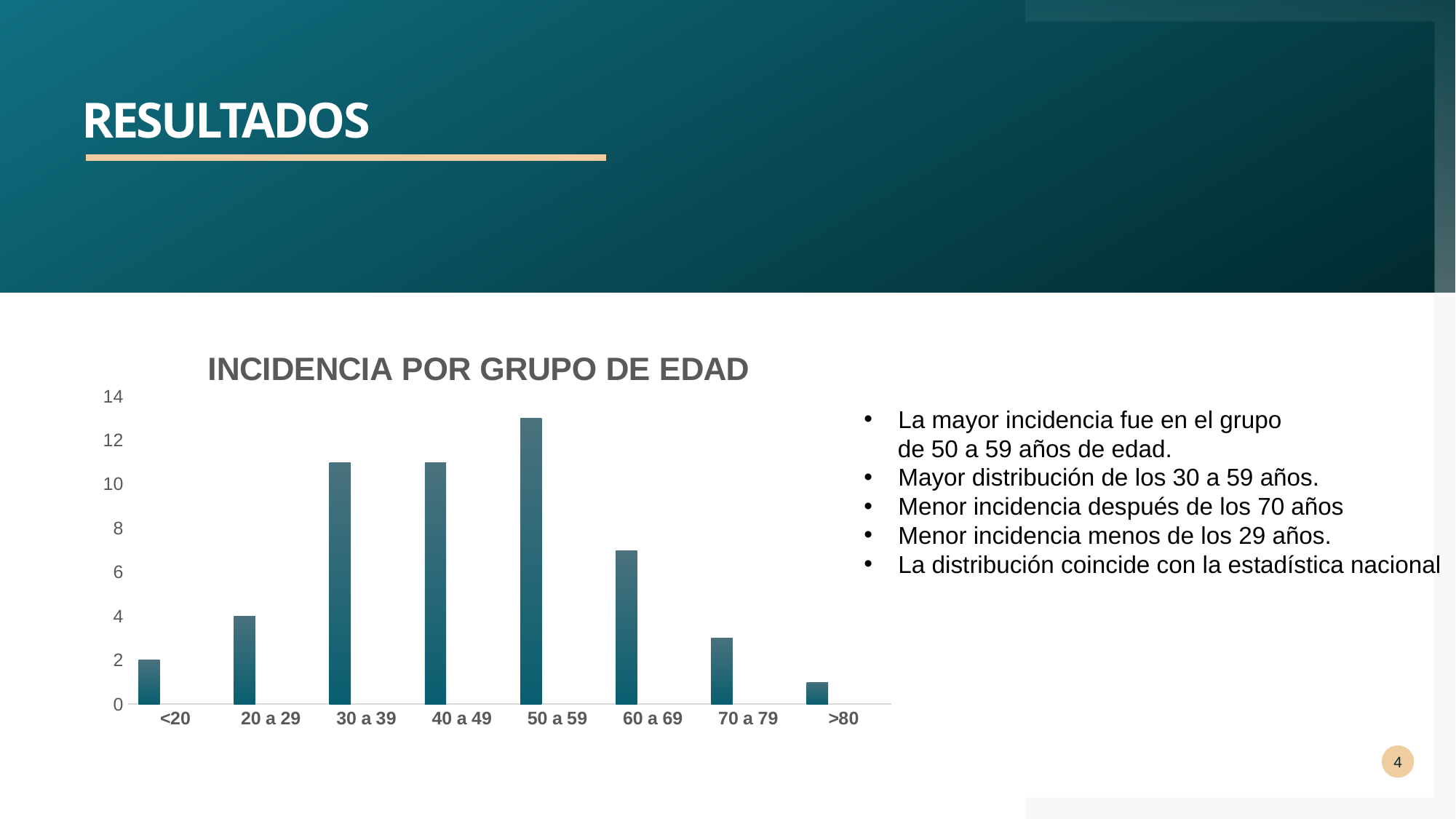
Do the values rise or fall along the x axis from 50 a 59 to >80? fall What is the value for the 20 a 29 age group? 4 What is the difference between the values for 20 a 29 and <20? 2 Which age group has the highest value in the chart? 50 a 59 What is the title of the chart? INCIDENCIA POR GRUPO DE EDAD What type of chart is shown on the slide? bar chart Is the value for 50 a 59 greater or less than 12? greater How many age groups are shown on the x axis of the chart? 8 Is the value for 60 a 69 greater or less than 8? less Which age group has the lowest value in the chart? >80 What is the value for the <20 age group? 2 Which is larger, the value for 50 a 59 or the value for 60 a 69? 50 a 59